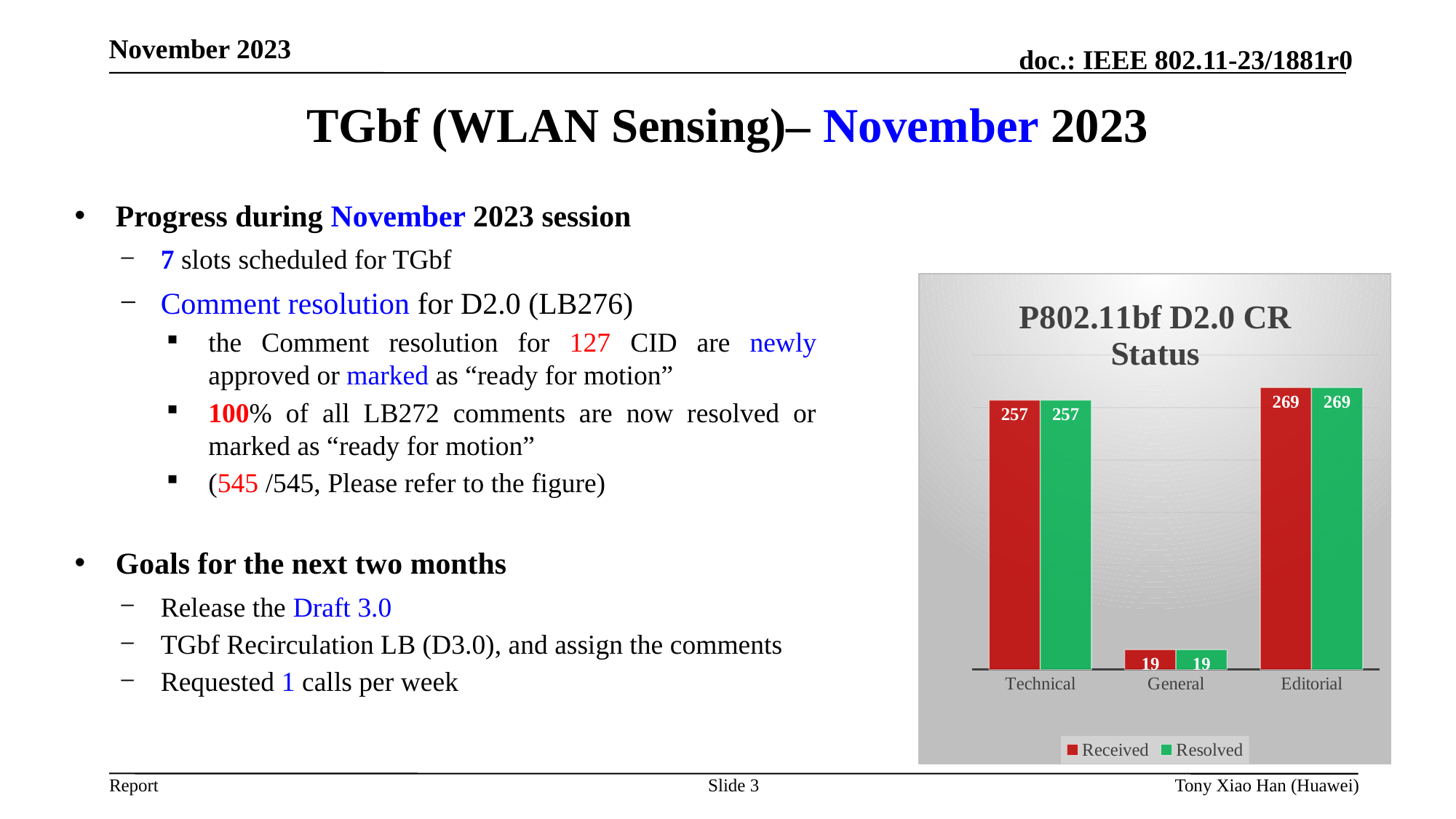
Which category has the highest Received value? Editorial What is the difference between the Resolved values for Technical and General? 238 How many series does the legend list? 2 What kind of chart is shown? bar chart How many categories are shown on the x axis? 3 Which is larger, the Received value for Technical or the Received value for General? Technical What is the title of the chart? P802.11bf D2.0 CR Status What is the Received value for Editorial? 269 What is the Received value for Technical? 257 What is the difference between the Received values for Editorial and Technical? 12 Which category has the lowest Resolved value? General What is the Resolved value for General? 19